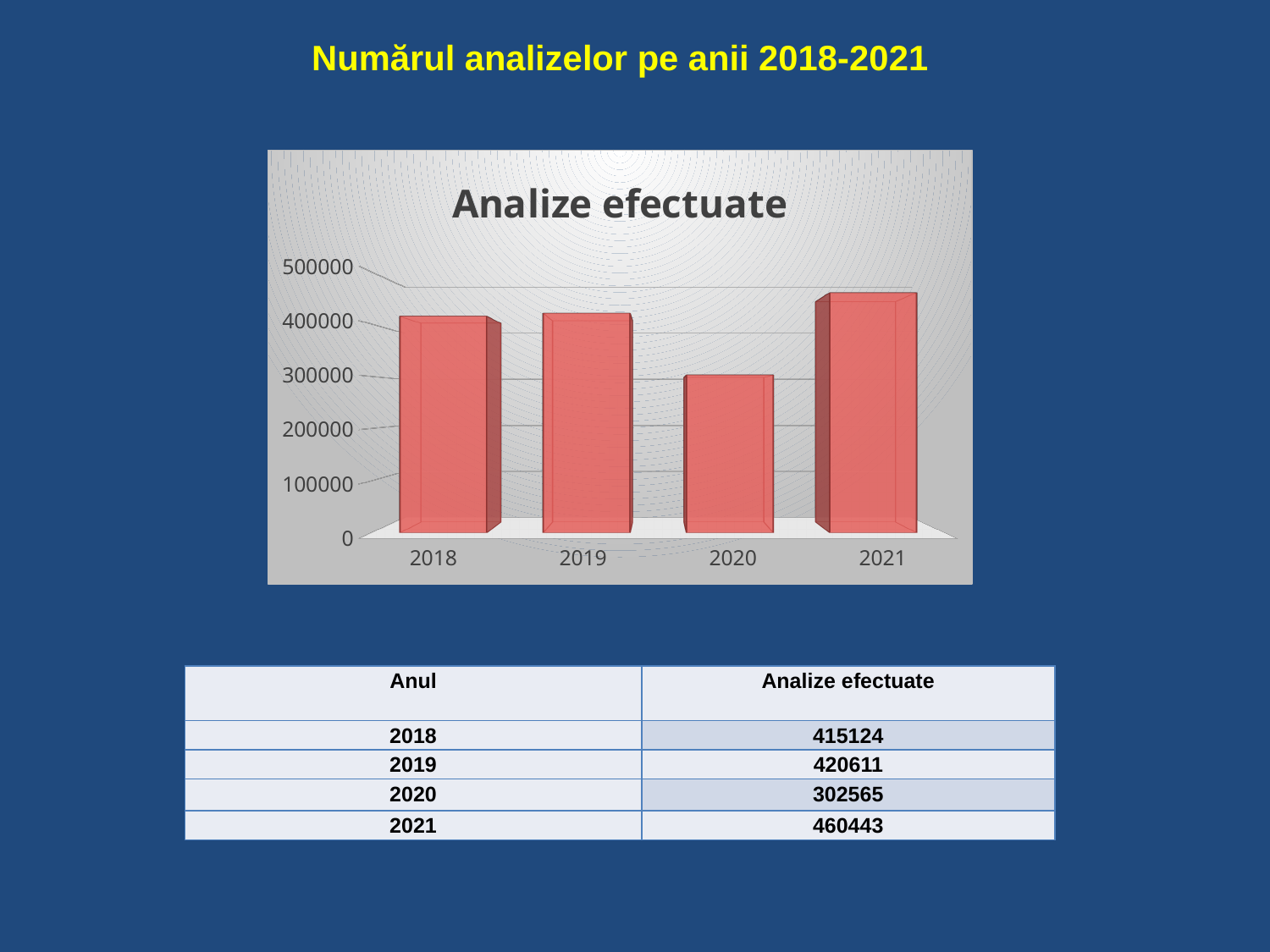
Which year has the highest number of analyses in the chart? 2021 What is the difference between the values for 2021 and 2020? 157878 What kind of chart is shown on the slide? bar chart Which is larger, the value for 2018 or the value for 2019? 2019 How many years are shown on the x axis of the chart? 4 What is the value for 2020 in the Analize efectuate chart? 302565 What is the value for 2018 in the Analize efectuate chart? 415124 What is the value for 2021 in the Analize efectuate chart? 460443 What is the difference between the values for 2019 and 2018? 5487 What is the title of the chart? Analize efectuate Is the value for 2020 greater or less than 400000? less Which year has the lowest number of analyses in the chart? 2020